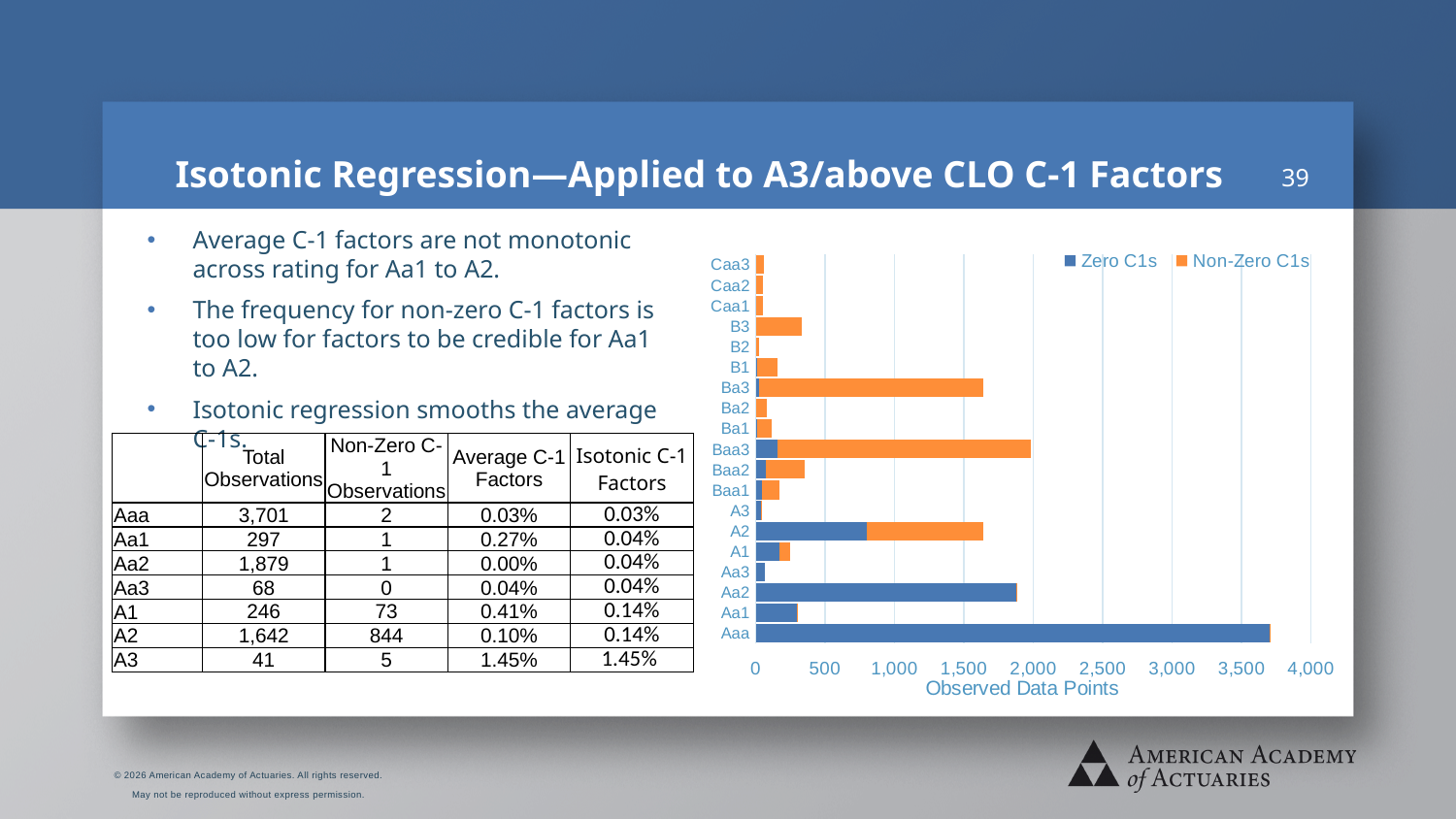
Is the total bar length for Aaa greater or less than 3,500? greater Which has the longer total bar, Ba3 or B3? Ba3 What kind of chart is shown on the slide? bar chart Is the Zero C1s value for A2 greater or less than 500? greater What are the two series named in the chart's legend? Zero C1s and Non-Zero C1s Is the total bar length for Aa2 greater or less than 2,000? less What is the title of the chart's horizontal axis? Observed Data Points Which rating category has the longest total bar in the chart? Aaa How many series does the chart's legend list? 2 How many rating categories are shown on the chart's vertical axis? 19 Which has the longer total bar, Aaa or Aa2? Aaa